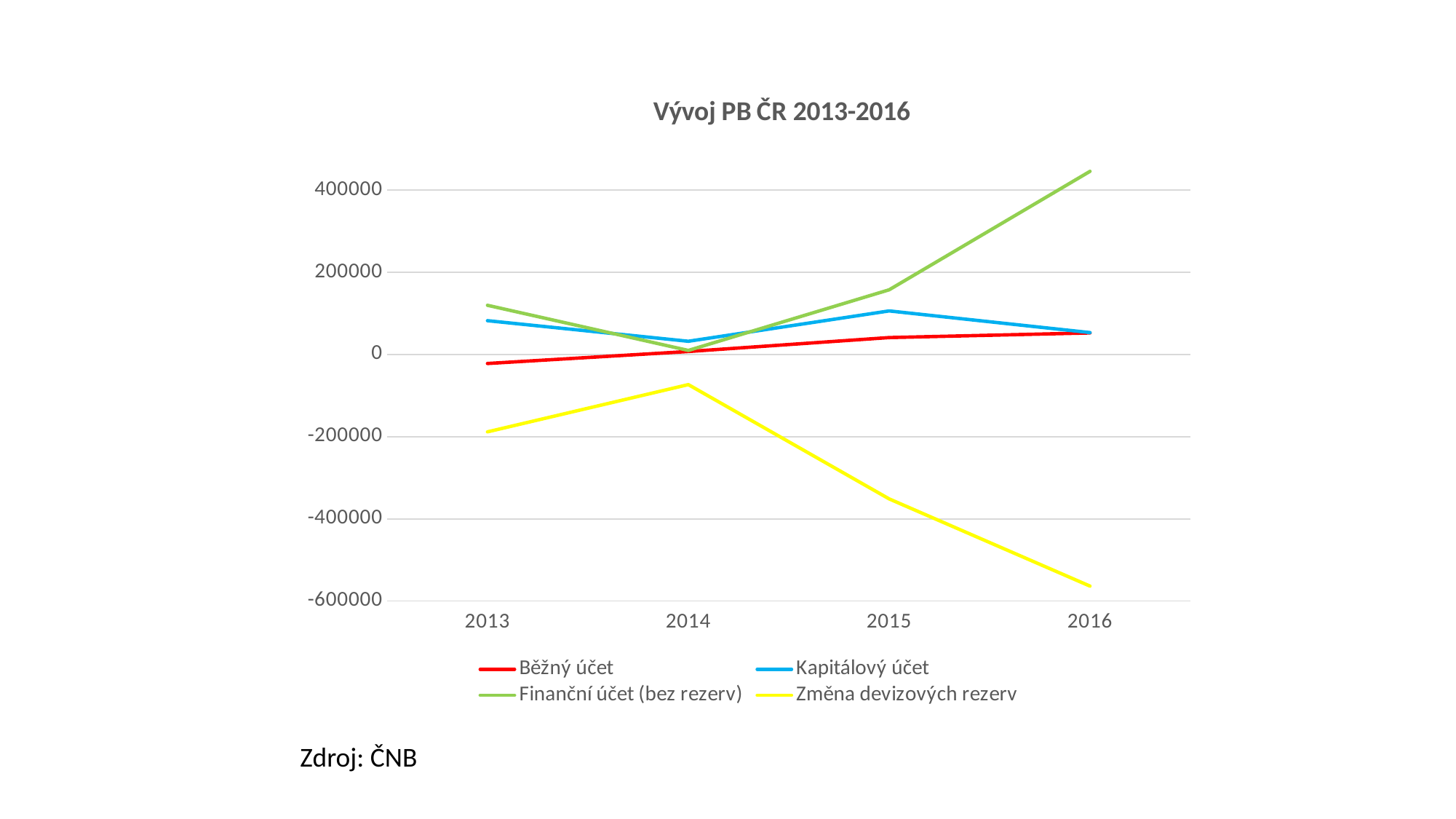
In which year is the Finanční účet (bez rezerv) series at its highest? 2016 Does the Běžný účet series rise or fall from 2013 to 2016? rise How many series does the legend list? 4 In which year is the Změna devizových rezerv series at its lowest? 2016 How many years are shown on the x axis? 4 In 2016, which is larger: Finanční účet (bez rezerv) or Kapitálový účet? Finanční účet (bez rezerv) Which colour is used for the Změna devizových rezerv series? yellow Is the value for Změna devizových rezerv in 2015 greater or less than -200000? less In 2013, which is larger: Kapitálový účet or Běžný účet? Kapitálový účet Is the value for Finanční účet (bez rezerv) in 2016 greater or less than 400000? greater What kind of chart is shown on the slide? line chart What is the title of the chart? Vývoj PB ČR 2013-2016